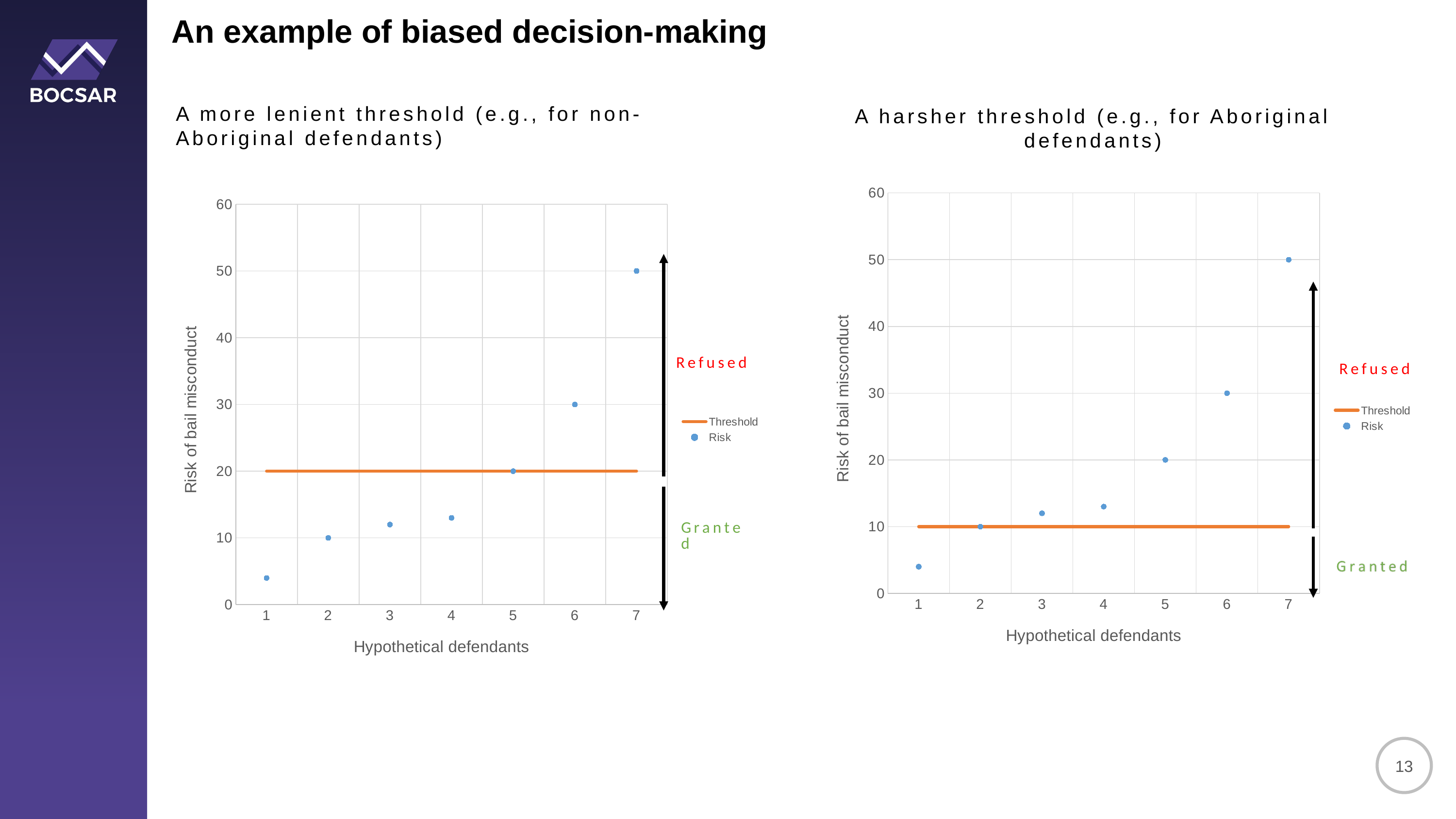
In the right chart ('A harsher threshold'), at what risk value is the Threshold line drawn? 10 In the right chart ('A harsher threshold'), which hypothetical defendant has the lowest risk of bail misconduct? 1 In the left chart ('A more lenient threshold'), which hypothetical defendant has the highest risk of bail misconduct? 7 In the left chart ('A more lenient threshold'), how many hypothetical defendants are plotted on the x axis? 7 What kind of chart is the left chart, 'A more lenient threshold'? scatter chart In the right chart ('A harsher threshold'), how many series does the legend list? 2 In the right chart ('A harsher threshold'), which has the larger risk value, defendant 3 or defendant 6? defendant 6 In the right chart ('A harsher threshold'), is the risk value for defendant 4 greater or less than 20? less In the left chart ('A more lenient threshold'), do the risk values rise or fall as the defendant number increases from 1 to 7? rise What is the label on the y axis of the right chart ('A harsher threshold')? Risk of bail misconduct In the left chart ('A more lenient threshold'), is the risk value for defendant 6 greater or less than 20? greater In the left chart ('A more lenient threshold'), at what risk value is the Threshold line drawn? 20